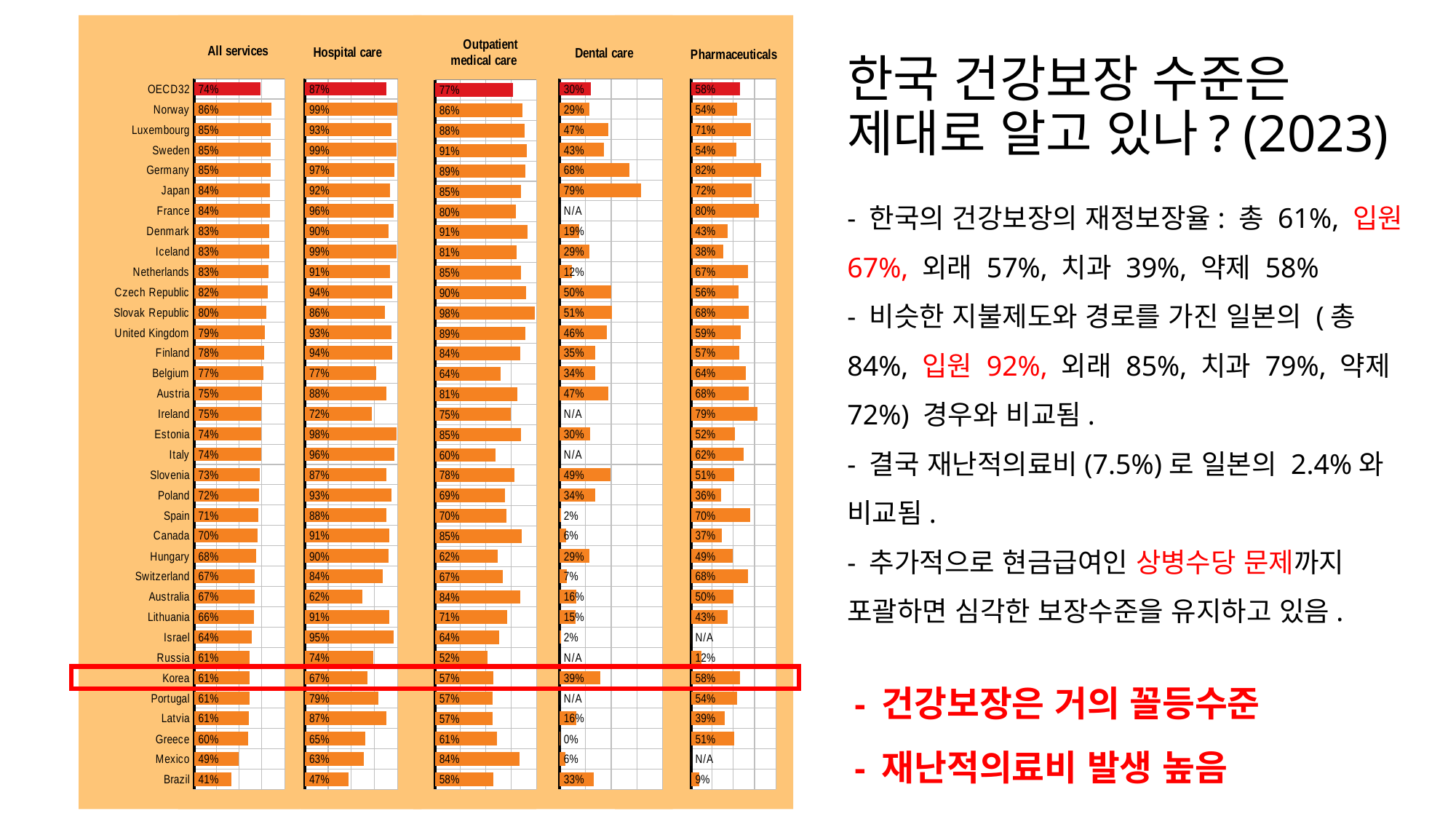
In the All services chart, what is the value for Korea? 61% In the Pharmaceuticals chart, which is larger, the value for Korea or the value for Japan? Japan In the Pharmaceuticals chart, what is the value for Germany? 82% In the Hospital care chart, what is the value for Korea? 67% In the Hospital care chart, which country has the lowest value? Brazil In the Outpatient medical care chart, what is the value for OECD32? 77% In the All services chart, which country has the lowest value? Brazil In the All services chart, what is the difference between Japan's value and Korea's value? 23 percentage points In the Dental care chart, what is the value for Japan? 79% In the Dental care chart, which country has the highest value? Japan What kind of chart is used for the All services panel? Bar chart Which row of the charts is highlighted with a red box? Korea